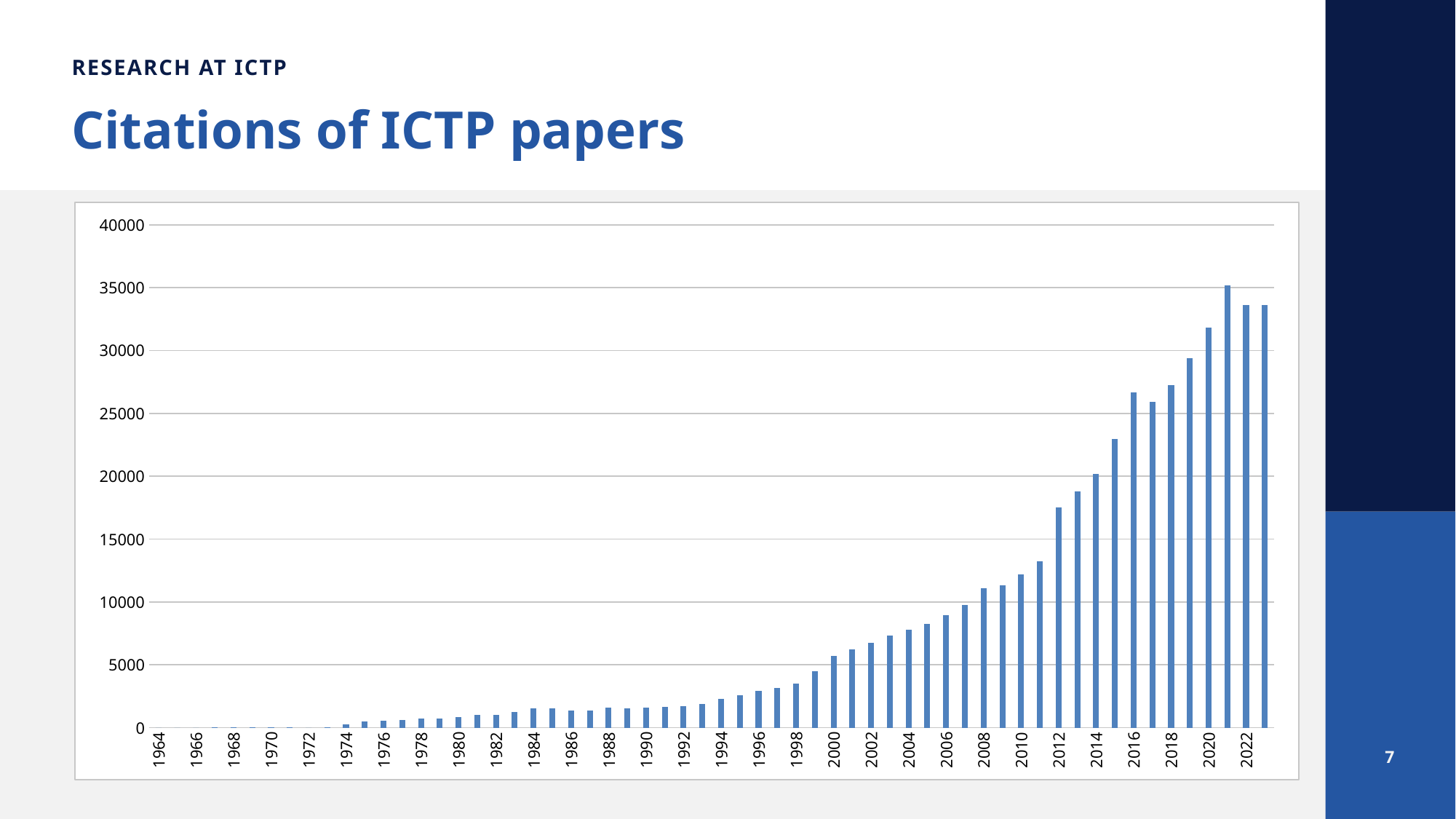
Overall, do the citation values rise or fall from 1964 to the most recent year? rise Is the value for 2022 greater or less than 30000? greater What is the title of the slide containing the chart? Citations of ICTP papers Is the value for 2006 greater or less than 10000? less Is the value for 1998 greater or less than 5000? less Which year has the larger value, 2012 or 2022? 2022 What kind of chart is shown on the slide? bar chart Which year has the larger value, 1990 or 2000? 2000 What is the highest value shown on the vertical axis of the chart? 40000